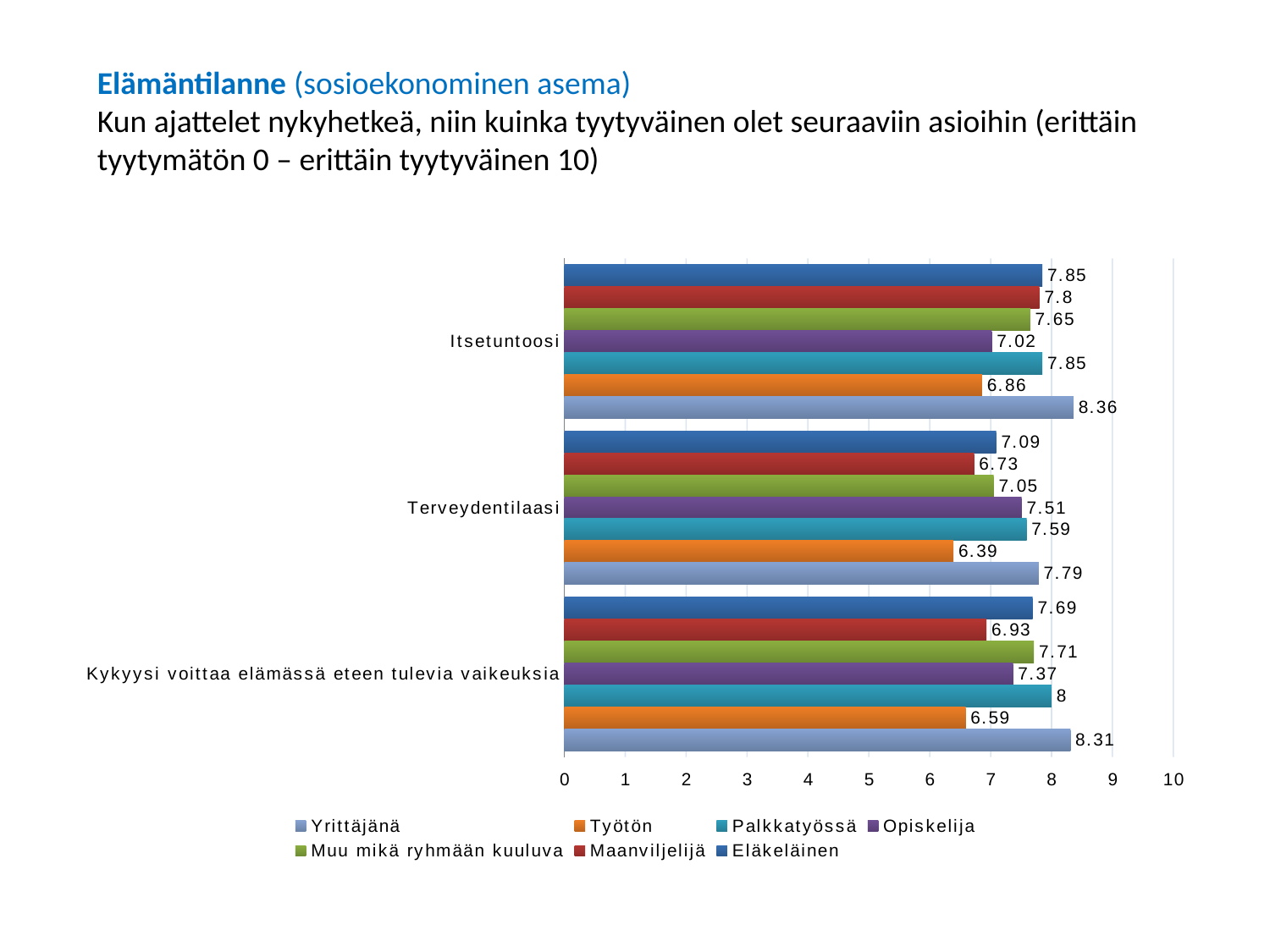
How many categories are shown on the y axis? 3 What kind of chart is shown on the slide? Bar chart What is the value for Opiskelija in the Terveydentilaasi category? 7.51 What is the difference between the Yrittäjänä and Työtön values in the Kykyysi voittaa elämässä eteen tulevia vaikeuksia category? 1.72 What is the value for Yrittäjänä in the Itsetuntoosi category? 8.36 What is the maximum value shown on the x axis? 10 Which series has the lowest value in the Terveydentilaasi category? Työtön How many series does the legend list? 7 What is the value for Palkkatyössä in the Kykyysi voittaa elämässä eteen tulevia vaikeuksia category? 8 What is the value for Työtön in the Terveydentilaasi category? 6.39 Which is larger in the Terveydentilaasi category: Eläkeläinen or Maanviljelijä? Eläkeläinen Which series has the highest value in the Itsetuntoosi category? Yrittäjänä